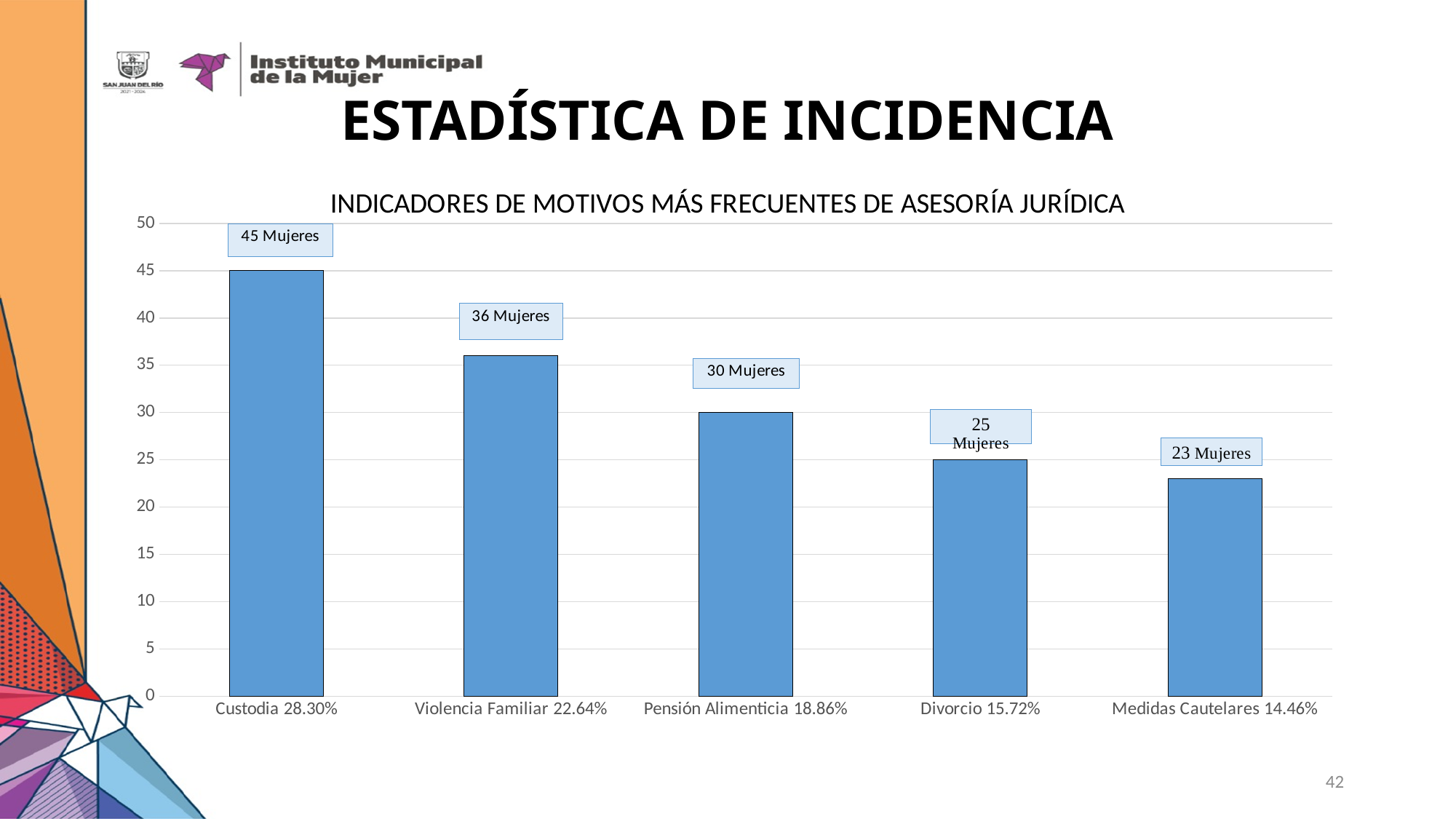
What is the value for Medidas Cautelares? 23 Mujeres What is the value for Violencia Familiar? 36 Mujeres Which category has the highest value? Custodia Is the value for Divorcio greater or less than 30? less What is the value for Custodia? 45 Mujeres What is the difference between the values for Custodia and Divorcio? 20 Which category has the lowest value? Medidas Cautelares What is the value for Pensión Alimenticia? 30 Mujeres What is the title of the chart? INDICADORES DE MOTIVOS MÁS FRECUENTES DE ASESORÍA JURÍDICA Which is larger, the value for Violencia Familiar or the value for Pensión Alimenticia? Violencia Familiar What kind of chart is shown on the slide? bar chart How many categories are shown on the x axis? 5